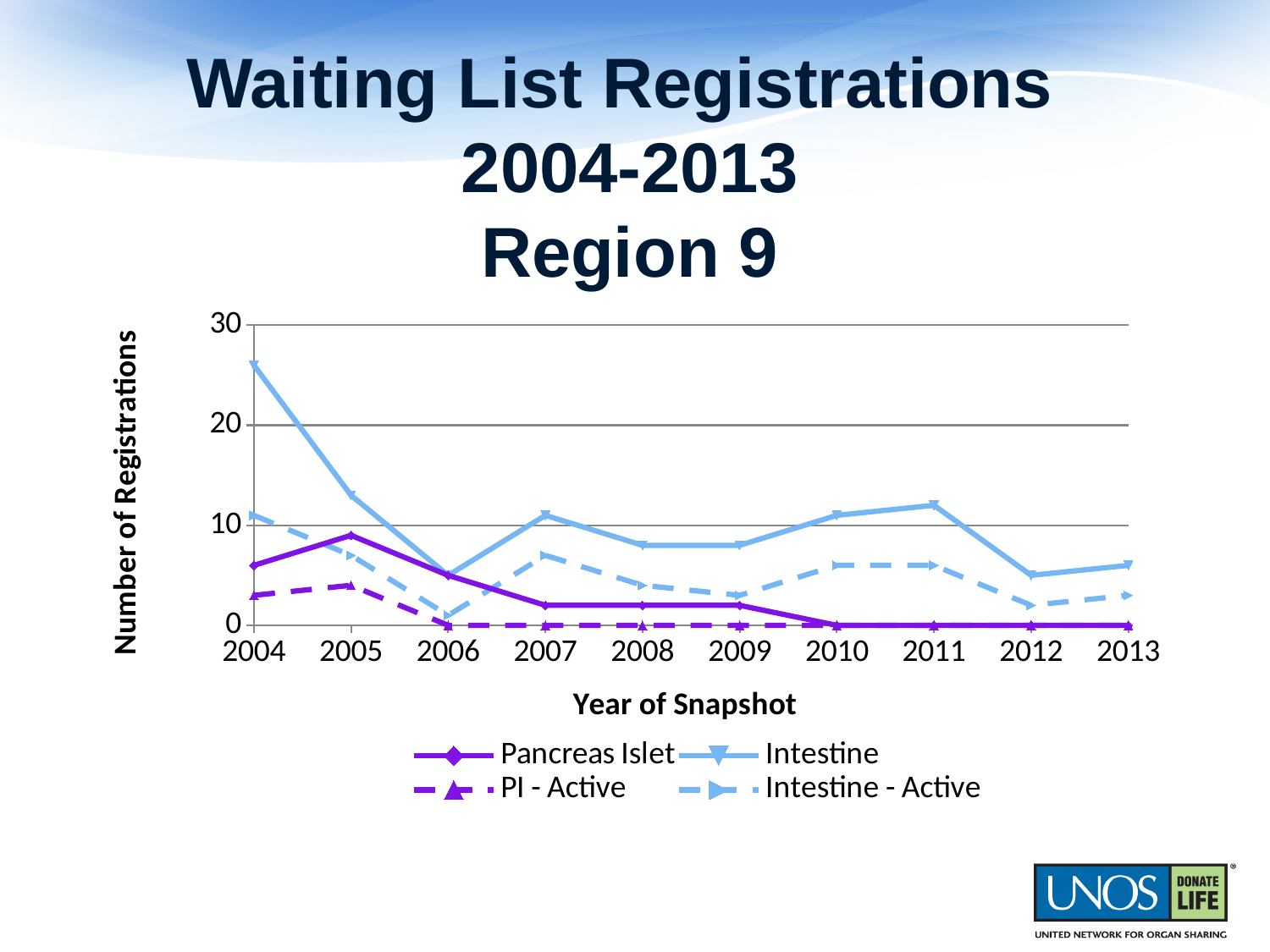
Is the value for Pancreas Islet in 2005 greater or less than 10? less What is the value for PI - Active in 2010? 0 How many series does the legend list? 4 In which year is the Pancreas Islet series at its highest? 2005 In which year is the Intestine series at its highest? 2004 How many years are shown on the x axis? 10 What is the label of the y axis? Number of Registrations Is the value for Intestine in 2004 greater or less than 20? greater What is the value for Pancreas Islet in 2013? 0 Does the Intestine series rise or fall from 2004 to 2006? fall Is the value for Intestine in 2005 greater or less than 10? greater What kind of chart is shown on the slide? line chart